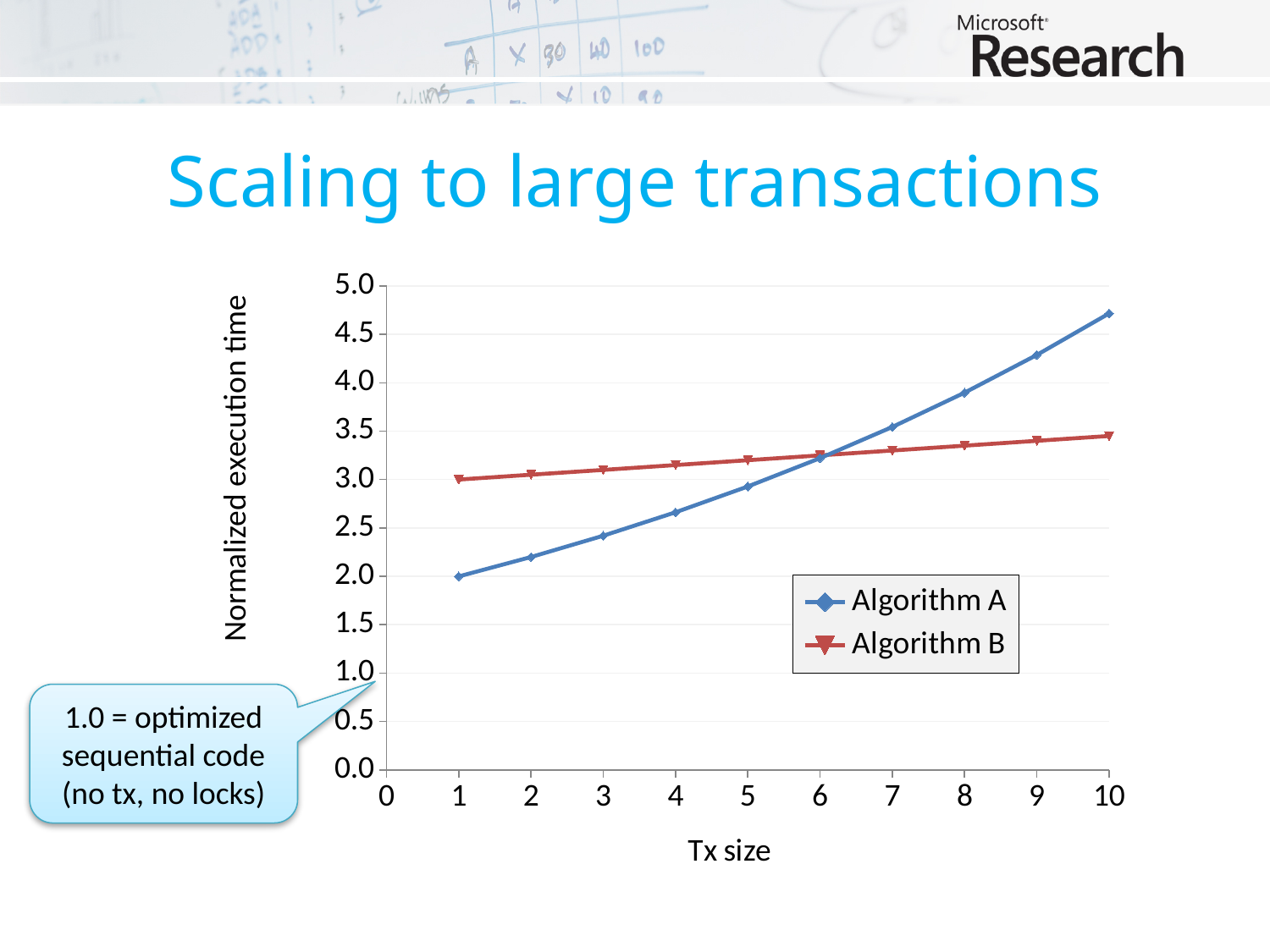
What is the normalized execution time for Algorithm B at Tx size 1? 3.0 Is the value for Algorithm A at Tx size 10 greater or less than 4.5? greater At Tx size 9, which series has the higher normalized execution time, Algorithm A or Algorithm B? Algorithm A How many data points are plotted for Algorithm B? 10 Is the value for Algorithm A at Tx size 4 greater or less than 3.0? less At Tx size 3, which series has the higher normalized execution time, Algorithm A or Algorithm B? Algorithm B What kind of chart is shown on the slide? line chart Does the normalized execution time for Algorithm A rise or fall as Tx size increases? rise What is the title of the y axis? Normalized execution time What is the normalized execution time for Algorithm A at Tx size 1? 2.0 Is the value for Algorithm B at Tx size 10 greater or less than 4.0? less How many series does the legend list? 2